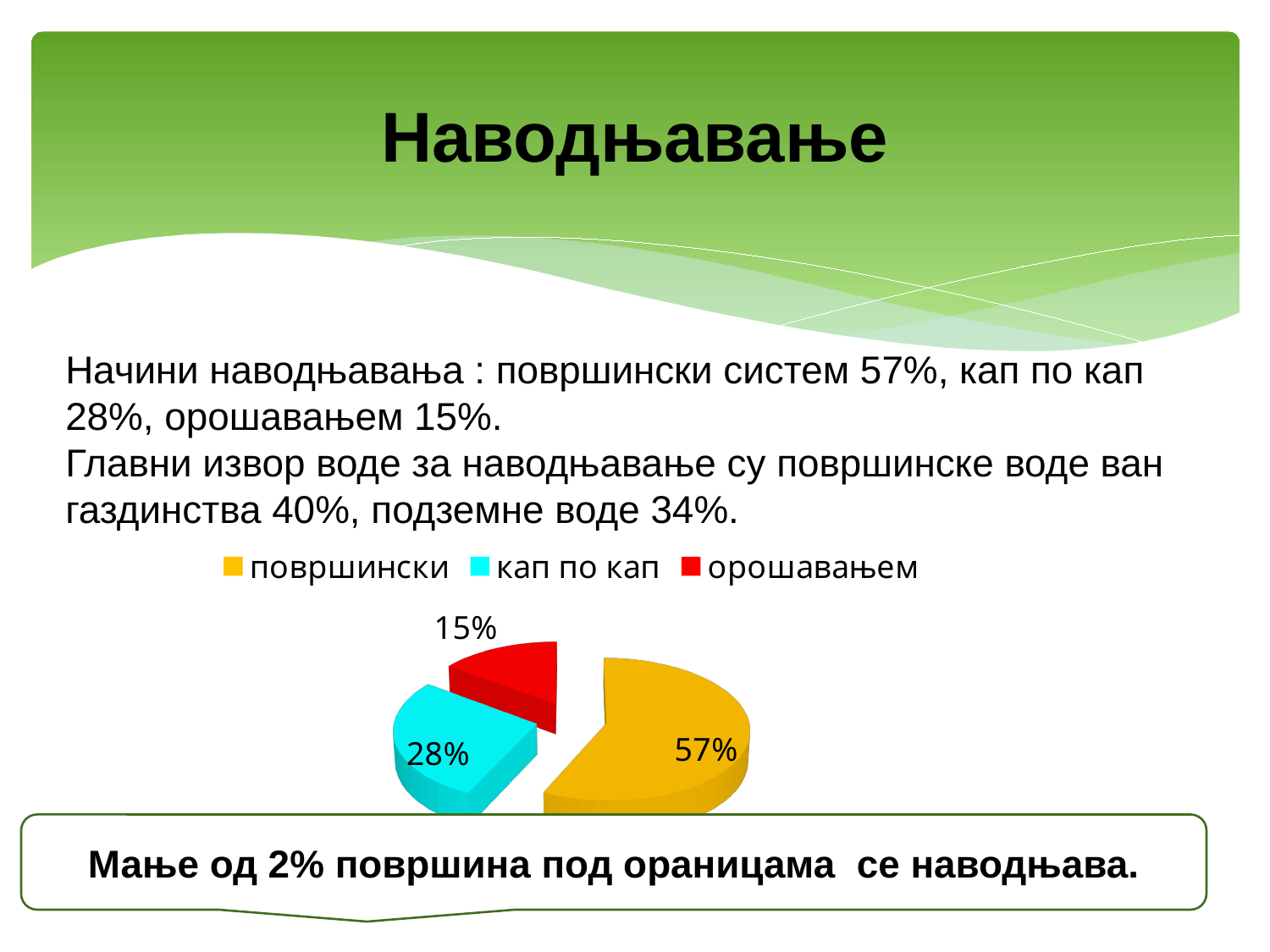
Which is larger, the кап по кап slice or the орошавањем slice? кап по кап What share of the pie does the површински slice have? 57% What is the difference in percentage points between the површински and кап по кап slices? 29 Which category has the largest slice of the pie? површински What share of the pie does the кап по кап slice have? 28% What colour is the кап по кап slice in the pie chart? cyan What is the difference in percentage points between the кап по кап and орошавањем slices? 13 What share of the pie does the орошавањем slice have? 15% How many slices does the pie chart have? 3 Which category has the smallest slice of the pie? орошавањем How many entries does the legend list? 3 What kind of chart is shown on the slide? pie chart